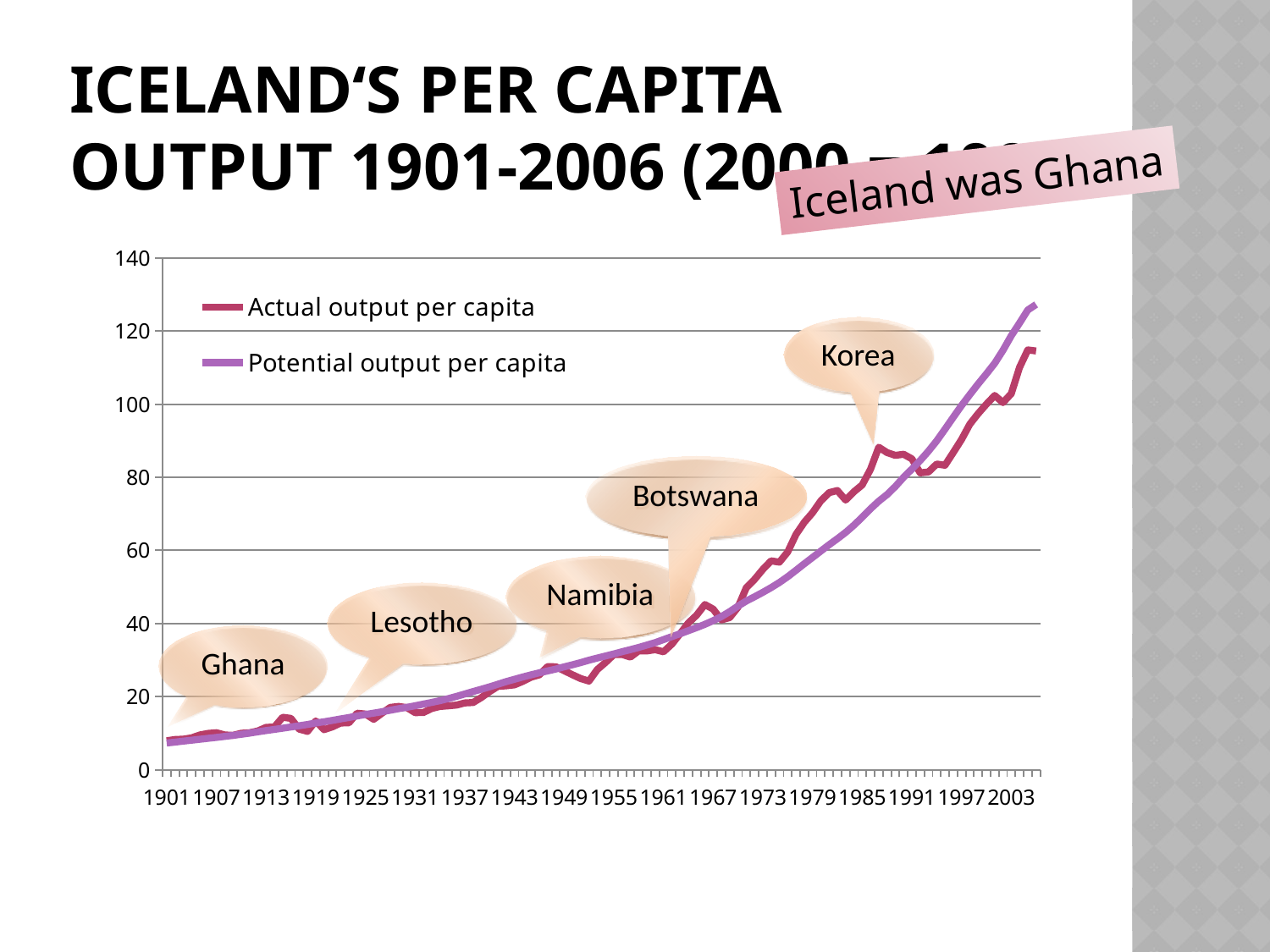
What kind of chart is shown on the slide? line chart Around 1985, which series has the higher value, Actual output per capita or Potential output per capita? Actual output per capita Do the values of the Potential output per capita series rise or fall from 1901 to 2003? rise How many series does the legend list? 2 How many year labels are shown along the horizontal axis? 18 Is the value of Actual output per capita in 1961 greater or less than 40? less In 2003, which series has the higher value, Actual output per capita or Potential output per capita? Potential output per capita What is the highest value shown on the vertical axis? 140 Is the value of Potential output per capita in 1901 greater or less than 20? less What are the two series named in the legend? Actual output per capita; Potential output per capita